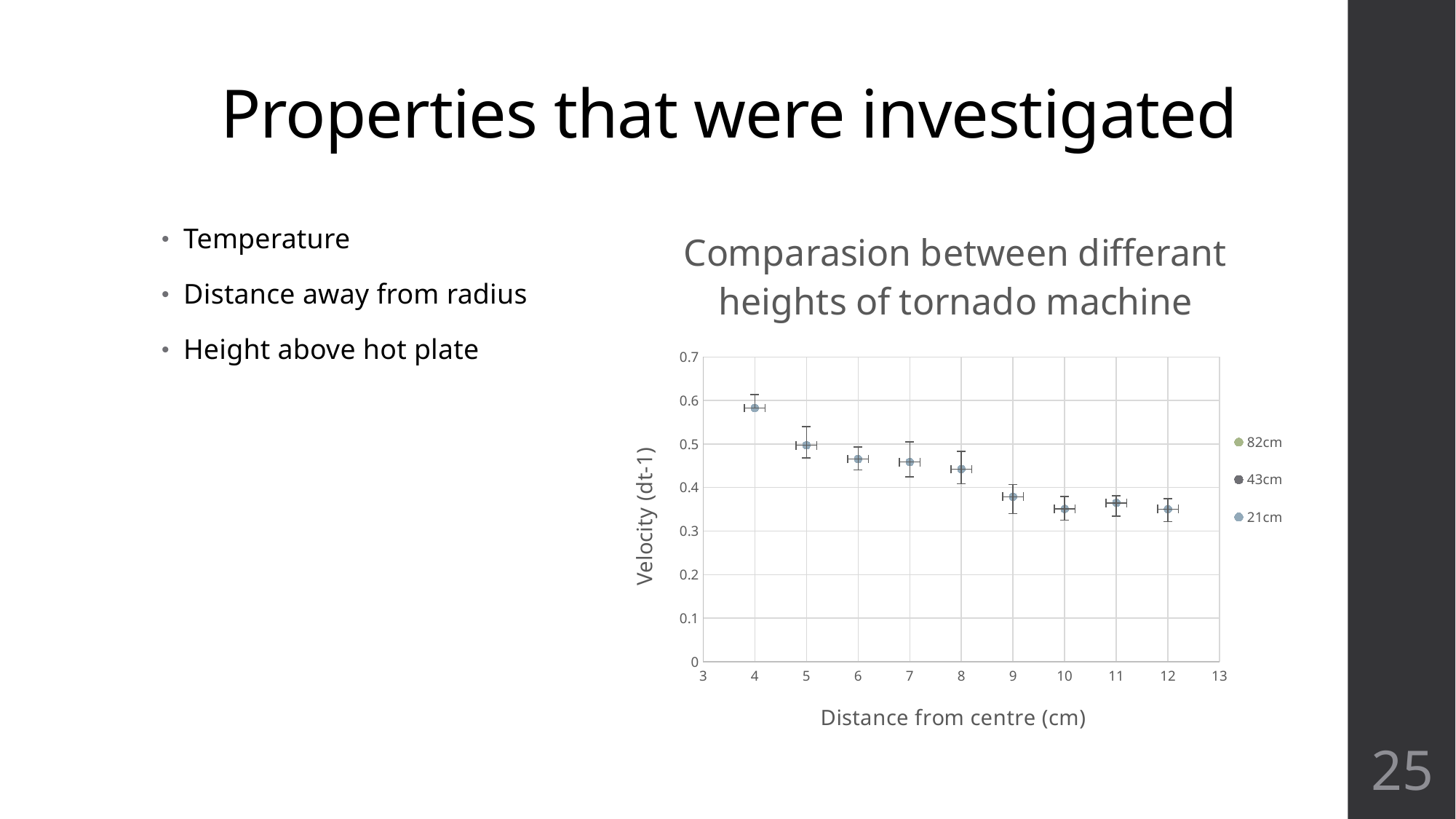
Which has the larger velocity value: the point at 4 cm or the point at 12 cm? 4 cm Is the velocity value at a distance of 9 cm greater or less than 0.4? less Is the velocity value at a distance of 4 cm greater or less than 0.5? greater How many series does the chart legend list? 3 Is the velocity value at a distance of 8 cm greater or less than 0.4? greater What are the three series named in the chart legend? 82cm, 43cm, 21cm Do the plotted velocity values rise or fall as distance from centre increases? fall Which has the larger velocity value: the point at 6 cm or the point at 9 cm? 6 cm At which distance from centre is the plotted velocity highest? 4 What is the label of the chart's y axis? Velocity (dt-1) What kind of chart is shown on the slide? scatter chart